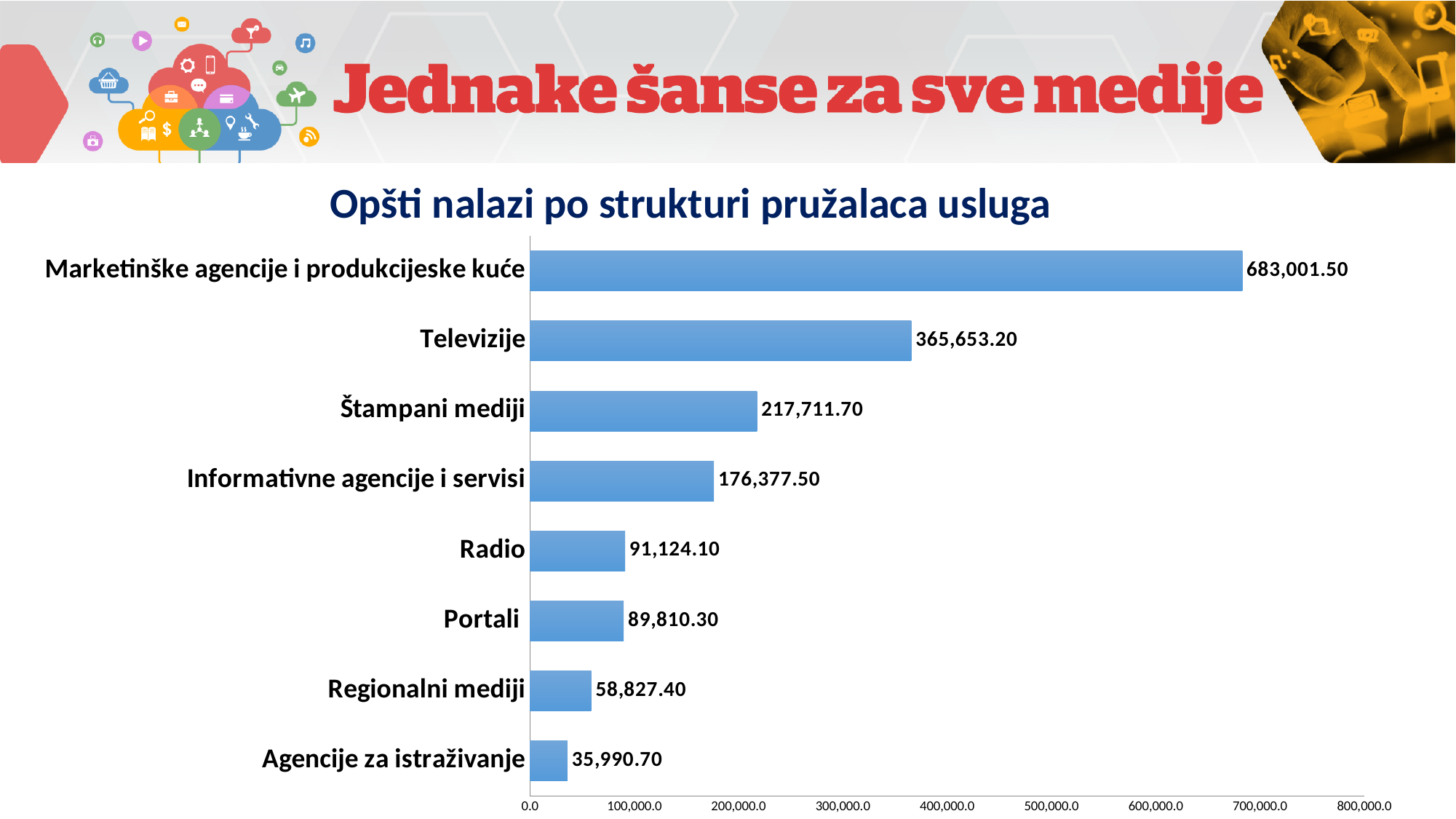
What is the title of the chart? Opšti nalazi po strukturi pružalaca usluga Which category has the highest value? Marketinške agencije i produkcijeske kuće What is the value for Televizije? 365,653.20 What is the difference between the values for Štampani mediji and Informativne agencije i servisi? 41,334.20 What kind of chart is shown on the slide? Bar chart Which is larger, the value for Televizije or the value for Štampani mediji? Televizije What is the difference between the values for Marketinške agencije i produkcijeske kuće and Televizije? 317,348.30 What is the value for Agencije za istraživanje? 35,990.70 Which category has the lowest value? Agencije za istraživanje How many categories are shown in the chart? 8 What is the value for Radio? 91,124.10 What is the value for Informativne agencije i servisi? 176,377.50